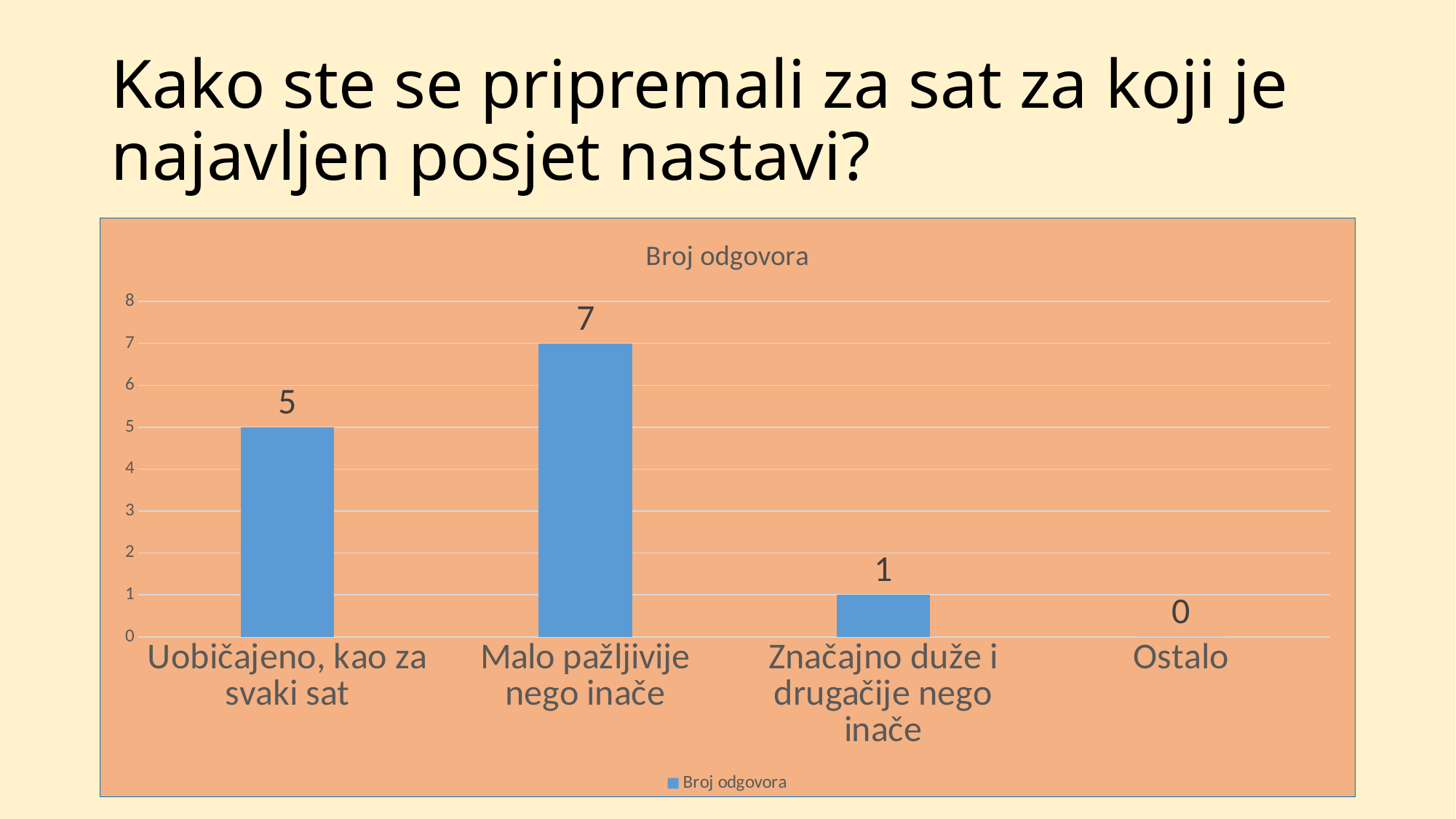
How many categories are shown on the x axis? 4 Which is larger: the value for "Uobičajeno, kao za svaki sat" or the value for "Značajno duže i drugačije nego inače"? Uobičajeno, kao za svaki sat What is the title of the chart? Broj odgovora How many series does the legend list? 1 What is the value for "Značajno duže i drugačije nego inače"? 1 What kind of chart is shown on the slide? Bar chart What is the value for "Ostalo"? 0 What is the difference between the values for "Malo pažljivije nego inače" and "Uobičajeno, kao za svaki sat"? 2 What is the value for "Uobičajeno, kao za svaki sat"? 5 Which category has the lowest value? Ostalo Which category has the highest value? Malo pažljivije nego inače What is the value for "Malo pažljivije nego inače"? 7